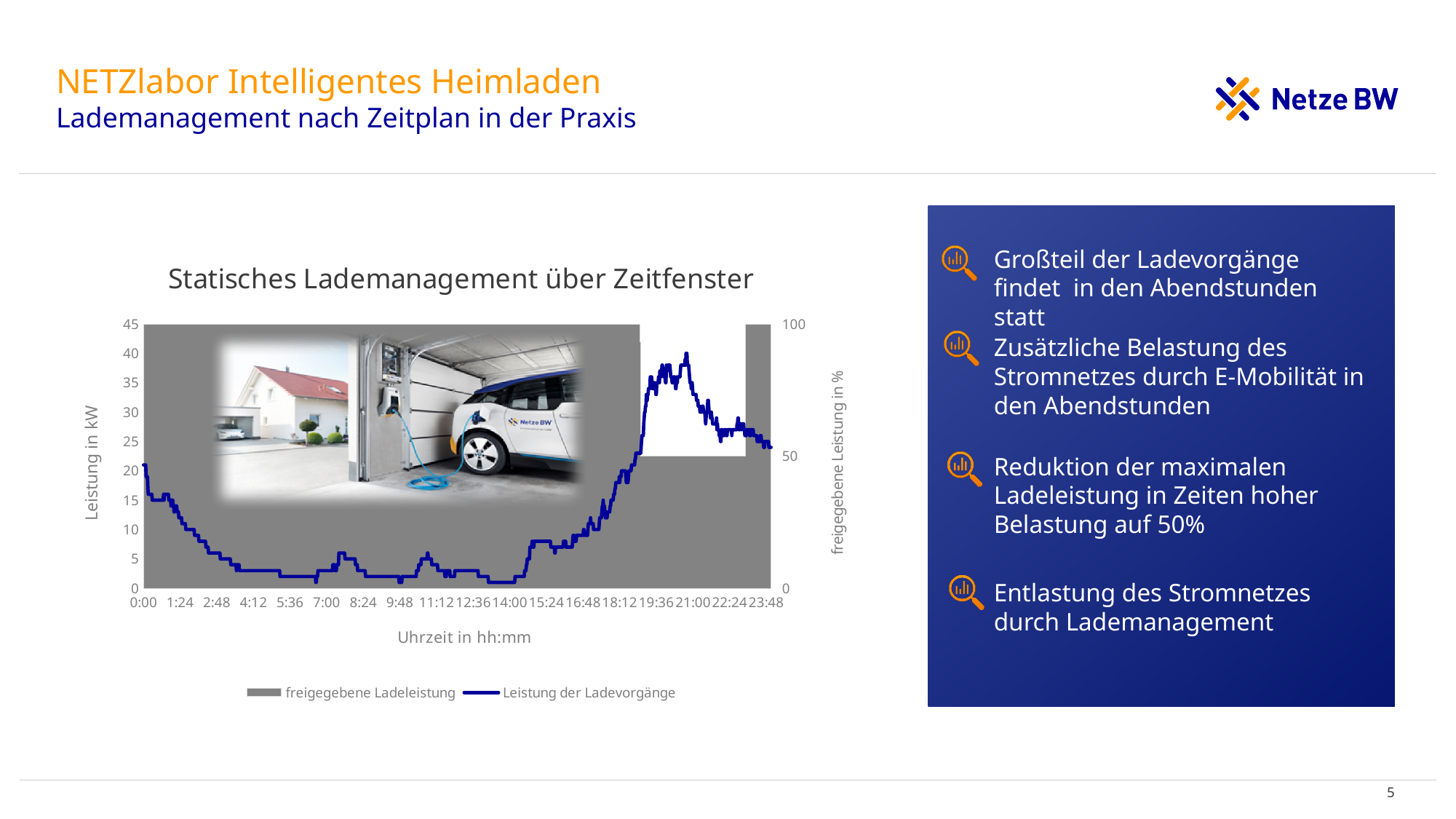
Is the peak value of 'Leistung der Ladevorgänge' near 21:00 greater or less than 35 kW? greater Is the value of 'Leistung der Ladevorgänge' at 0:00 greater or less than 15 kW? greater What is the title of the chart on the slide? Statisches Lademanagement über Zeitfenster What is the label of the left vertical axis of the chart? Leistung in kW How many series does the chart legend list? 2 Is the 'freigegebene Ladeleistung' at 21:00 greater or less than 100%? less Near which x-axis tick does 'Leistung der Ladevorgänge' reach its highest value? 21:00 Does 'Leistung der Ladevorgänge' rise or fall between 14:00 and 21:00? rise Does 'Leistung der Ladevorgänge' rise or fall between 0:00 and 7:00? fall What kind of chart is used to show 'Leistung der Ladevorgänge'? line chart